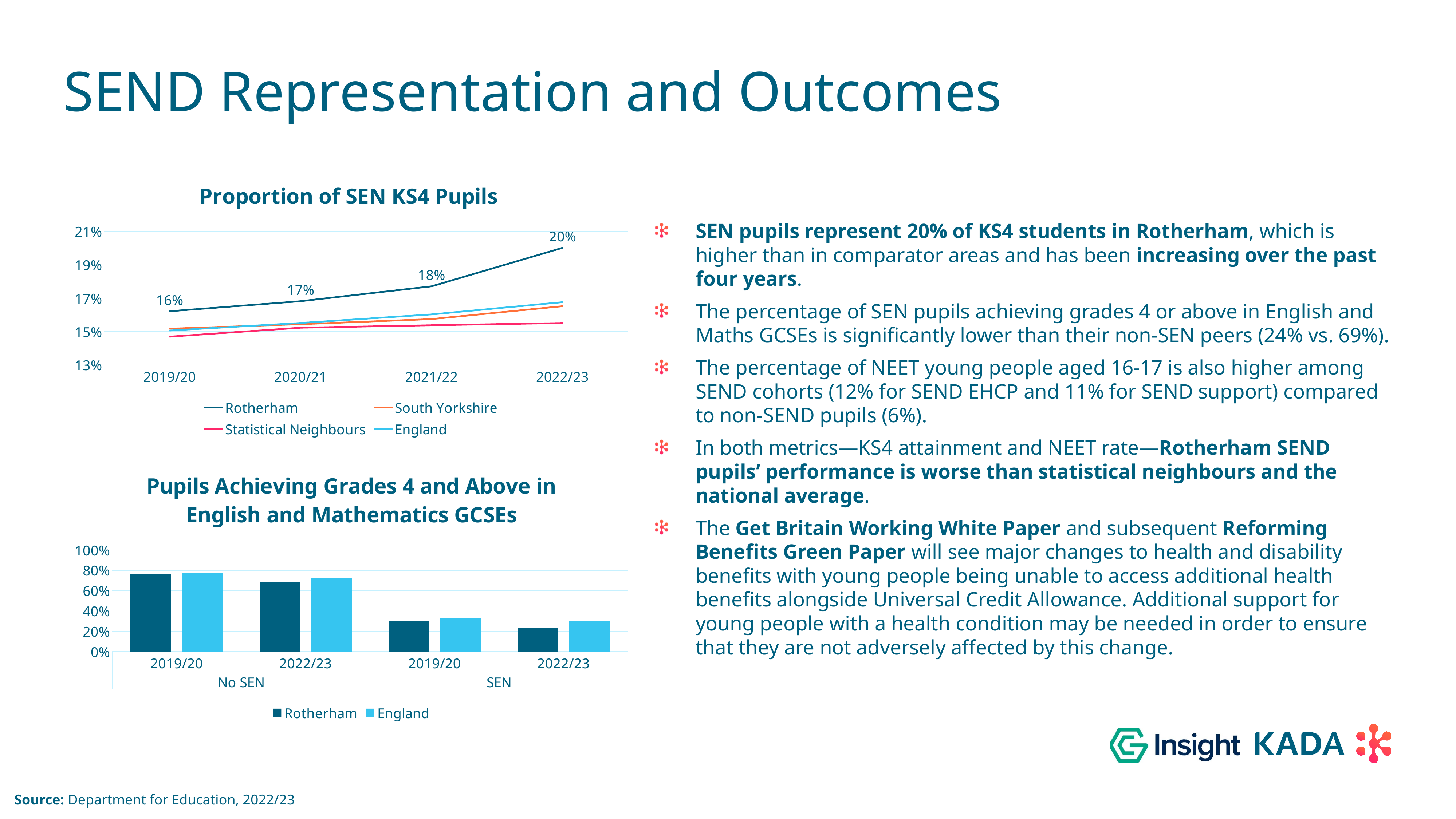
In the 'Proportion of SEN KS4 Pupils' chart, by how many percentage points did the Rotherham value rise from 2019/20 to 2022/23? 4 percentage points In the 'Proportion of SEN KS4 Pupils' chart, what is the Rotherham value for 2022/23? 20% In the 'Proportion of SEN KS4 Pupils' chart, which series has the highest value in 2022/23? Rotherham In the 'Proportion of SEN KS4 Pupils' chart, how many series does the legend list? 4 In the 'Proportion of SEN KS4 Pupils' chart, what is the Rotherham value for 2021/22? 18% In the 'Pupils Achieving Grades 4 and Above in English and Mathematics GCSEs' chart, is the England value for SEN in 2019/20 greater or less than 40%? less What kind of chart is 'Pupils Achieving Grades 4 and Above in English and Mathematics GCSEs'? bar chart In the 'Proportion of SEN KS4 Pupils' chart, does the Rotherham line rise or fall from 2019/20 to 2022/23? rise In the 'Pupils Achieving Grades 4 and Above in English and Mathematics GCSEs' chart, is the Rotherham value for No SEN in 2019/20 greater or less than 60%? greater In the 'Proportion of SEN KS4 Pupils' chart, which series has the lowest value in 2022/23? Statistical Neighbours In the 'Pupils Achieving Grades 4 and Above in English and Mathematics GCSEs' chart, how many series does the legend list? 2 In the 'Proportion of SEN KS4 Pupils' chart, what is the Rotherham value for 2019/20? 16%